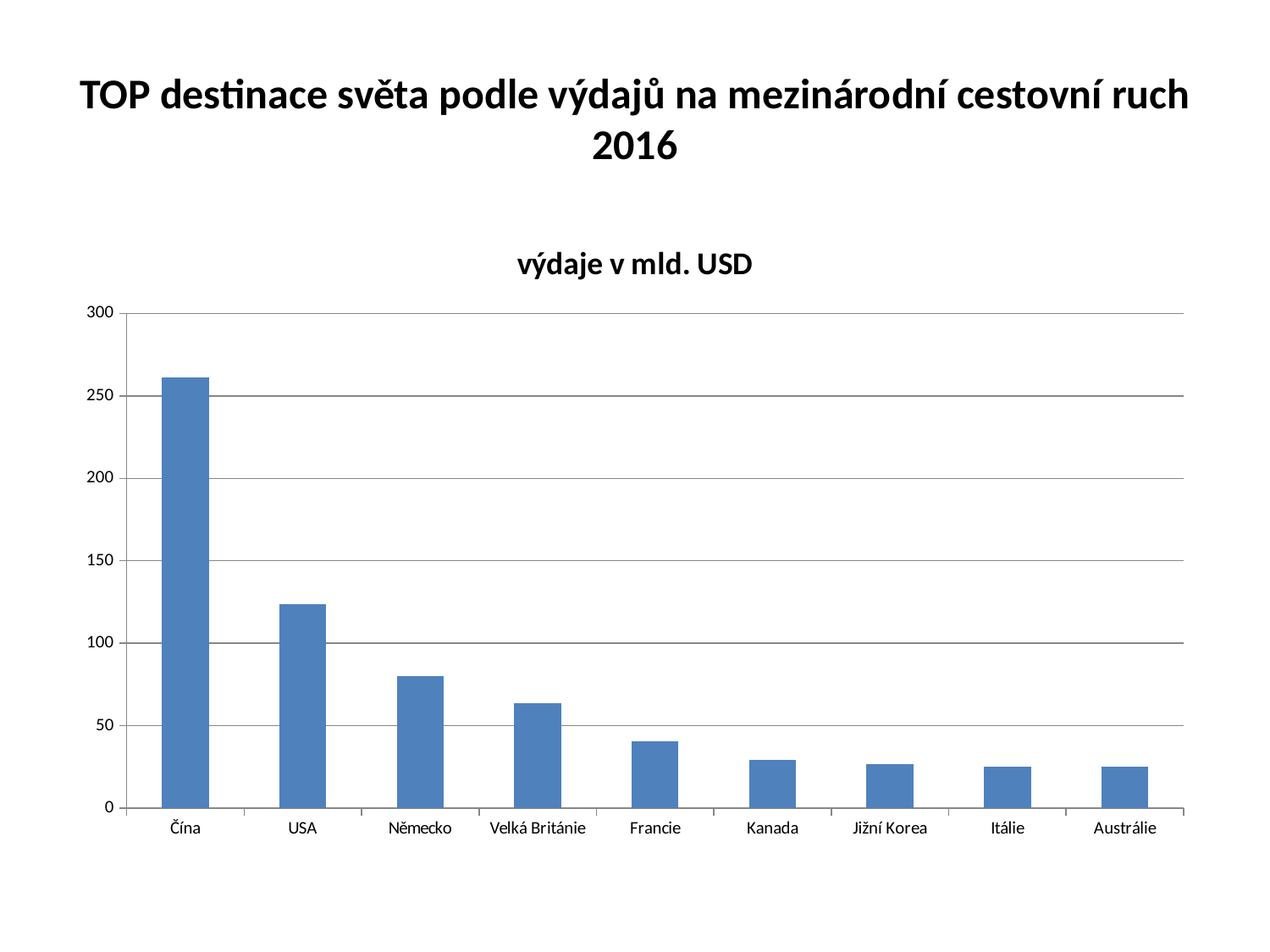
What is the title shown above the chart? výdaje v mld. USD Is the value for Německo greater or less than 100? less Is the value for Francie greater or less than 50? less Which is larger, the value for USA or the value for Německo? USA Is the value for Velká Británie greater or less than 50? greater Which country has the highest value in the chart? Čína Do the values rise or fall moving from left to right along the x axis? fall How many countries are shown on the x axis of the chart? 9 What kind of chart is shown on the slide? bar chart